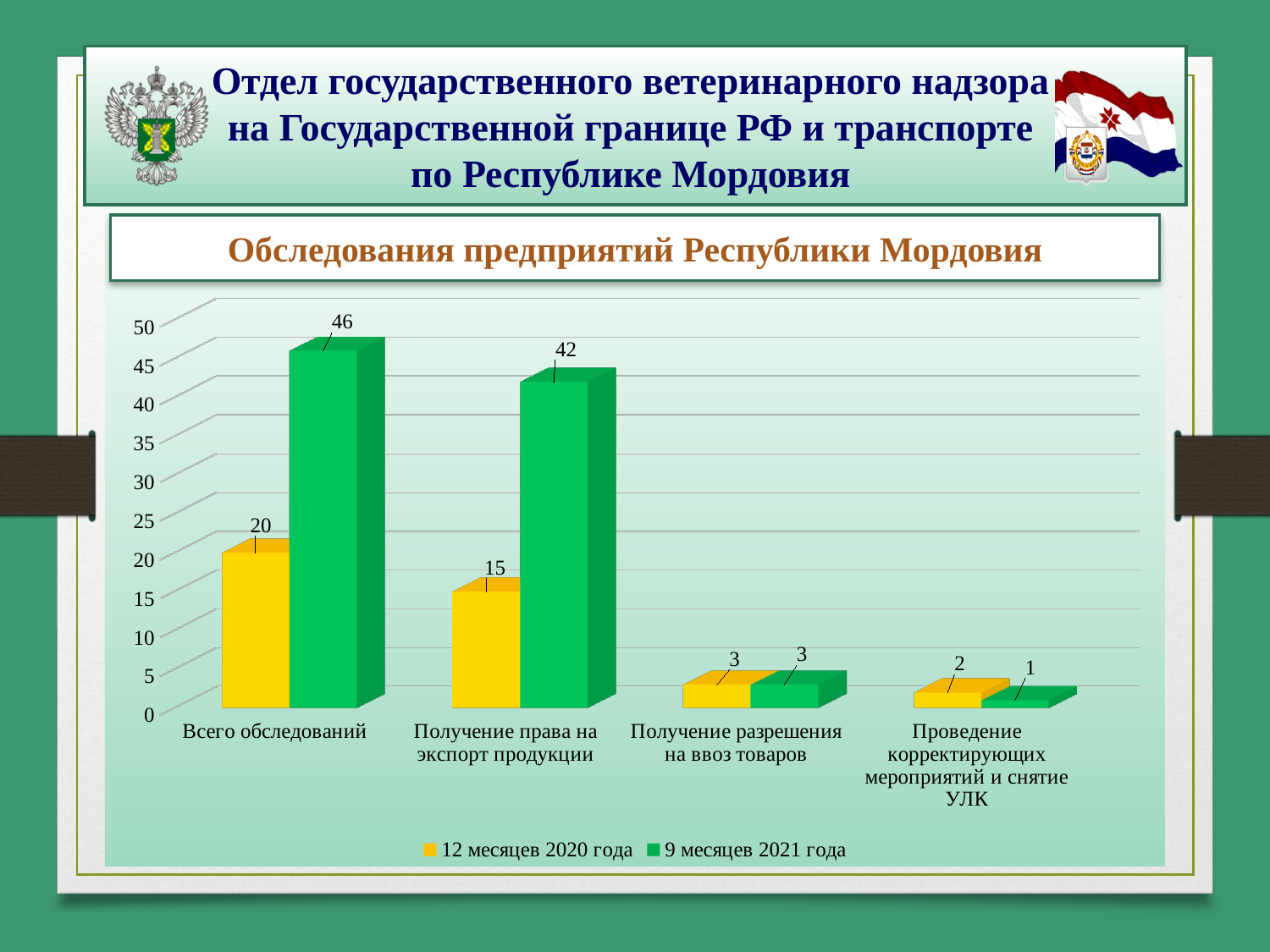
What is the difference between the '9 месяцев 2021 года' and '12 месяцев 2020 года' values for 'Получение права на экспорт продукции'? 27 Which category has the highest value in the '9 месяцев 2021 года' series? Всего обследований How many categories are shown on the x axis of the chart? 4 What is the title of the chart? Обследования предприятий Республики Мордовия What is the difference between the '9 месяцев 2021 года' and '12 месяцев 2020 года' values for 'Всего обследований'? 26 How many series does the legend list? 2 What kind of chart is shown on the slide? Bar chart Which category has the lowest value in the '12 месяцев 2020 года' series? Проведение корректирующих мероприятий и снятие УЛК Which is larger for 'Получение права на экспорт продукции': the '12 месяцев 2020 года' value or the '9 месяцев 2021 года' value? 9 месяцев 2021 года What is the value for 'Проведение корректирующих мероприятий и снятие УЛК' in the '9 месяцев 2021 года' series? 1 What is the value for 'Всего обследований' in the '9 месяцев 2021 года' series? 46 What is the value for 'Получение права на экспорт продукции' in the '12 месяцев 2020 года' series? 15